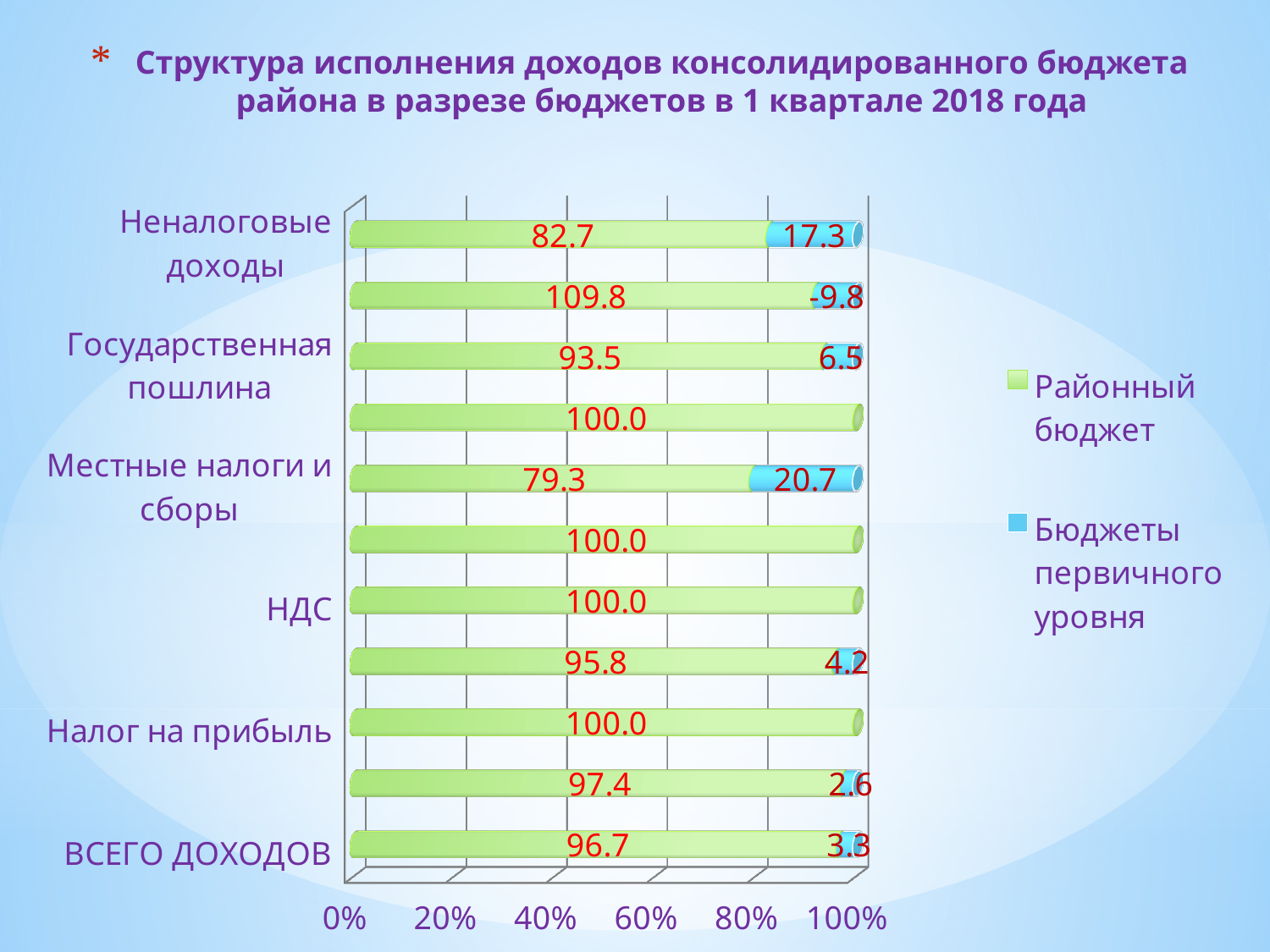
How many bars are plotted in the chart? 11 What is the value of Районный бюджет for НДС? 100.0 What is the value of Бюджеты первичного уровня for Местные налоги и сборы? 20.7 How many series does the legend list? 2 What is the value of Районный бюджет for Государственная пошлина? 93.5 What is the value of Районный бюджет for Неналоговые доходы? 82.7 What is the difference between the Районный бюджет values for Государственная пошлина and Местные налоги и сборы? 14.2 What is the value of Бюджеты первичного уровня for Неналоговые доходы? 17.3 What is the value of Бюджеты первичного уровня for ВСЕГО ДОХОДОВ? 3.3 What kind of chart is shown on the slide? bar chart Which is larger: the Бюджеты первичного уровня value for Местные налоги и сборы or for Государственная пошлина? Местные налоги и сборы What are the two series named in the legend? Районный бюджет; Бюджеты первичного уровня